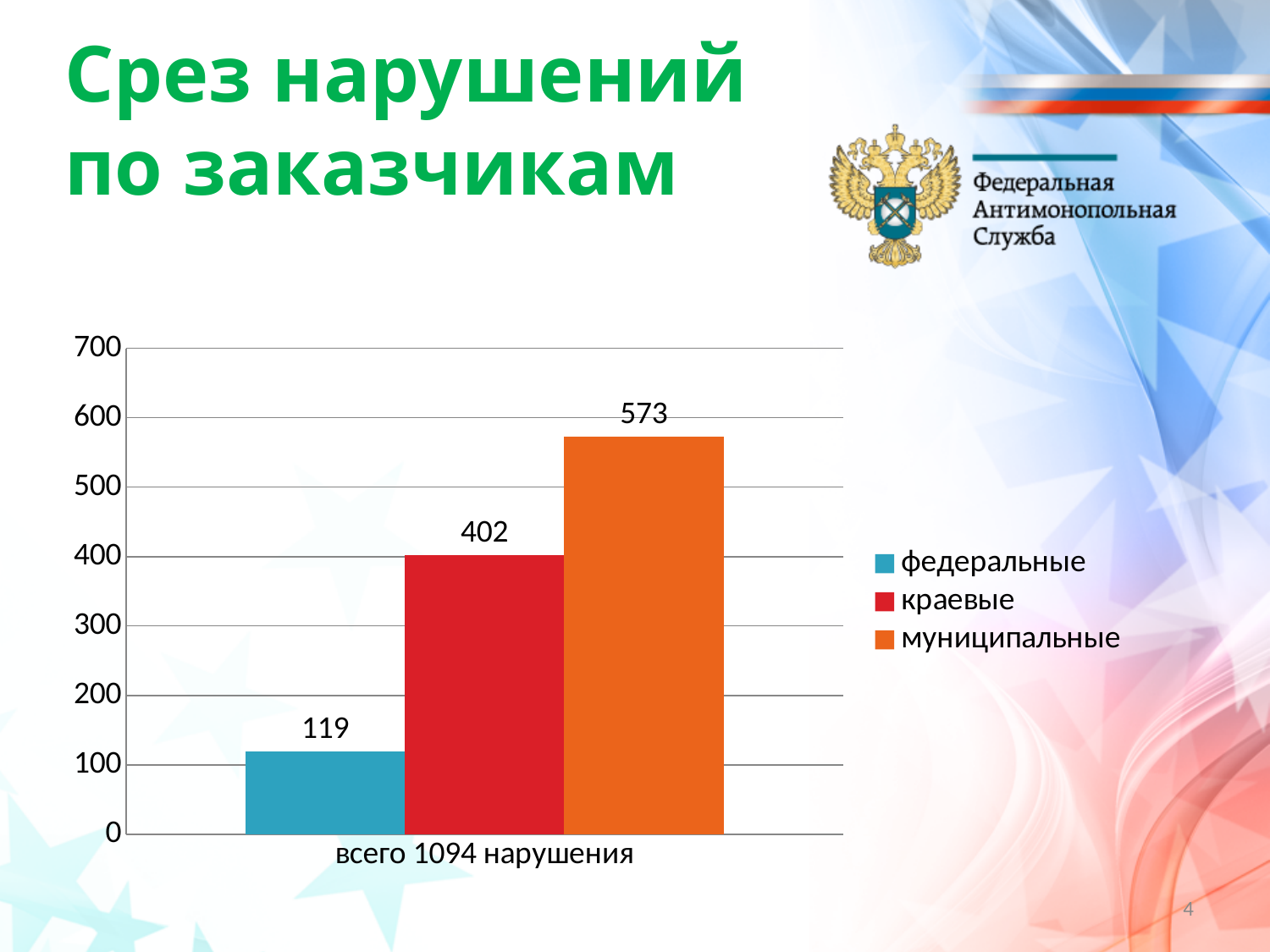
What is the difference between the values for краевые and федеральные? 283 Which series has the highest value? муниципальные What is the label shown on the x axis under the bars? всего 1094 нарушения Is the value for муниципальные greater or less than 500? greater Which series has the lowest value? федеральные What kind of chart is shown on the slide? bar chart What is the difference between the values for муниципальные and краевые? 171 How many series does the legend list? 3 Which is larger, the value for краевые or the value for федеральные? краевые What is the value for краевые? 402 What is the value for муниципальные? 573 What is the value for федеральные? 119